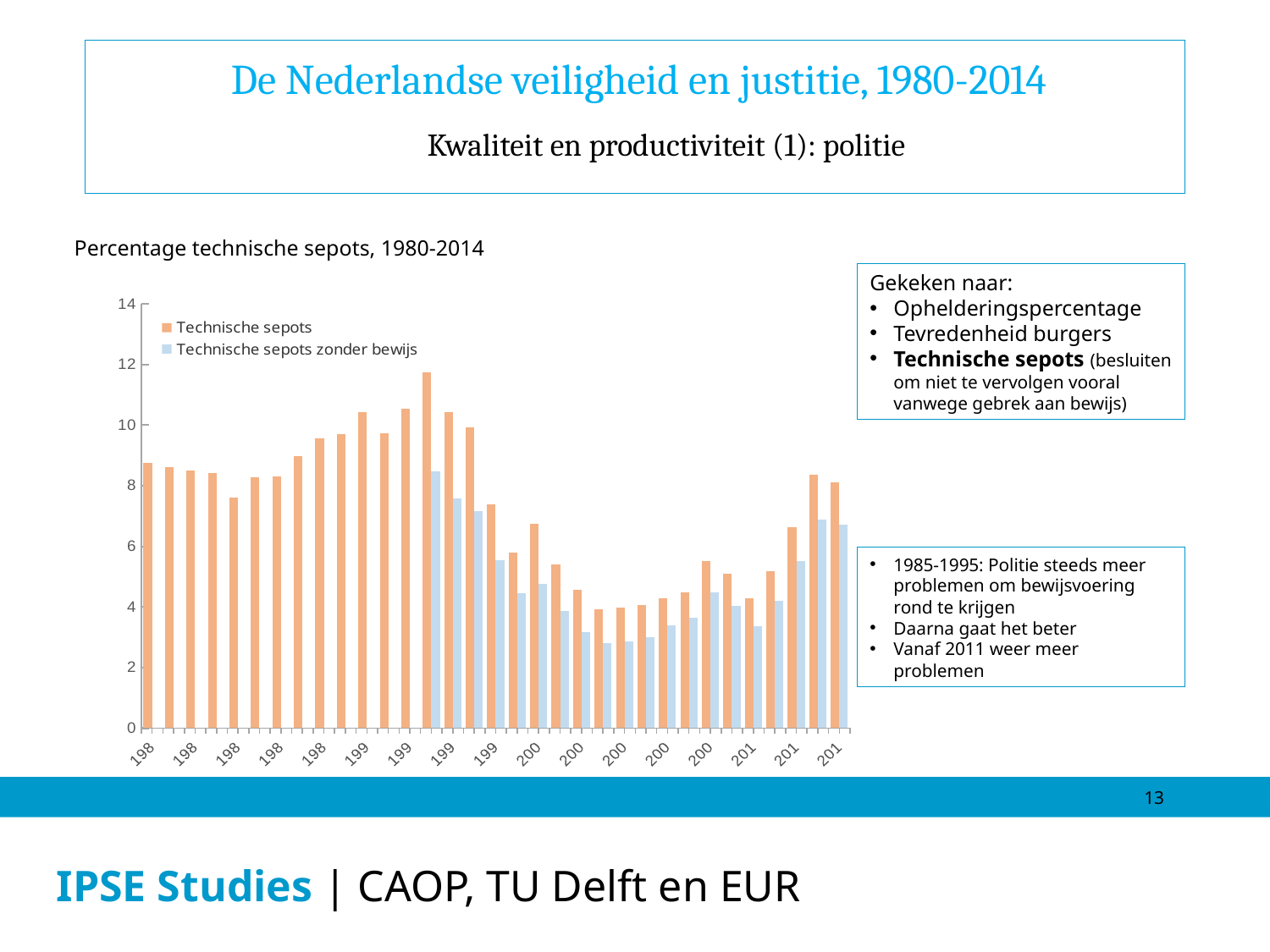
What kind of chart is shown on the slide? bar chart Is the highest value of the Technische sepots series greater or less than 10? greater Which series is shown in orange in the chart? Technische sepots What is the title of the chart? Percentage technische sepots, 1980-2014 Is the lowest value of the Technische sepots series greater or less than 2? greater Do the Technische sepots values rise or fall over the last few years shown on the chart? rise Is the highest value of the Technische sepots zonder bewijs series greater or less than 8? greater Which series has the higher values throughout the chart, Technische sepots or Technische sepots zonder bewijs? Technische sepots What is the highest value shown on the y axis of the chart? 14 How many series does the chart legend list? 2 Do the Technische sepots values rise or fall in the years immediately after the tallest bar? fall